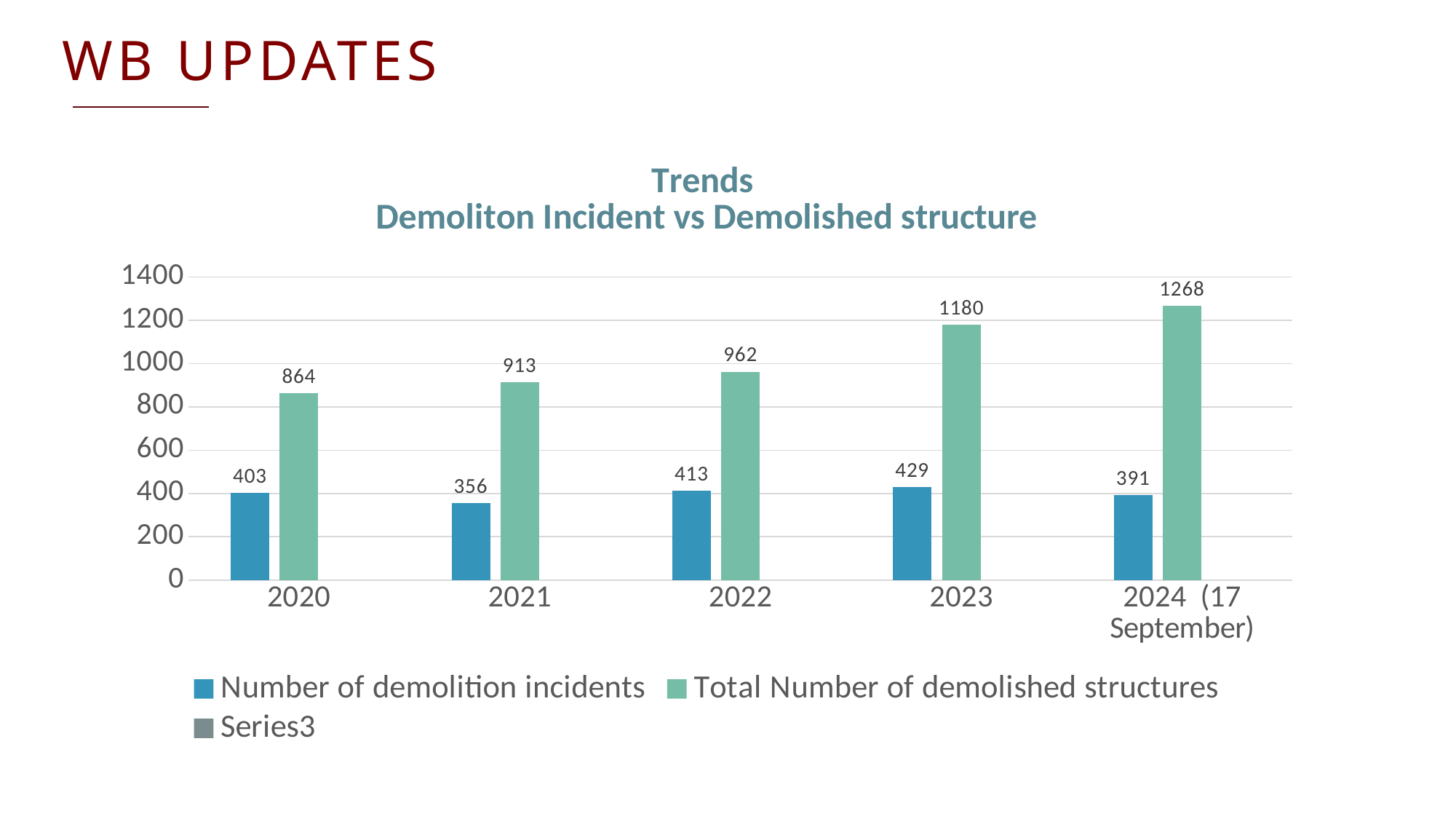
Does the total number of demolished structures rise or fall from 2020 to 2024 (17 September)? rise What is the number of demolition incidents in 2020? 403 How many years are shown on the x axis? 5 Which year has the lowest number of demolition incidents? 2021 What is the difference between the total number of demolished structures in 2023 and in 2022? 218 What kind of chart is shown on the slide? bar chart Is the total number of demolished structures in 2021 greater or less than 1000? less What is the total number of demolished structures in 2024 (17 September)? 1268 How many series does the legend list? 3 What is the total number of demolished structures in 2023? 1180 Which year has the highest total number of demolished structures? 2024 (17 September) Which is larger: the number of demolition incidents in 2023 or in 2024 (17 September)? 2023